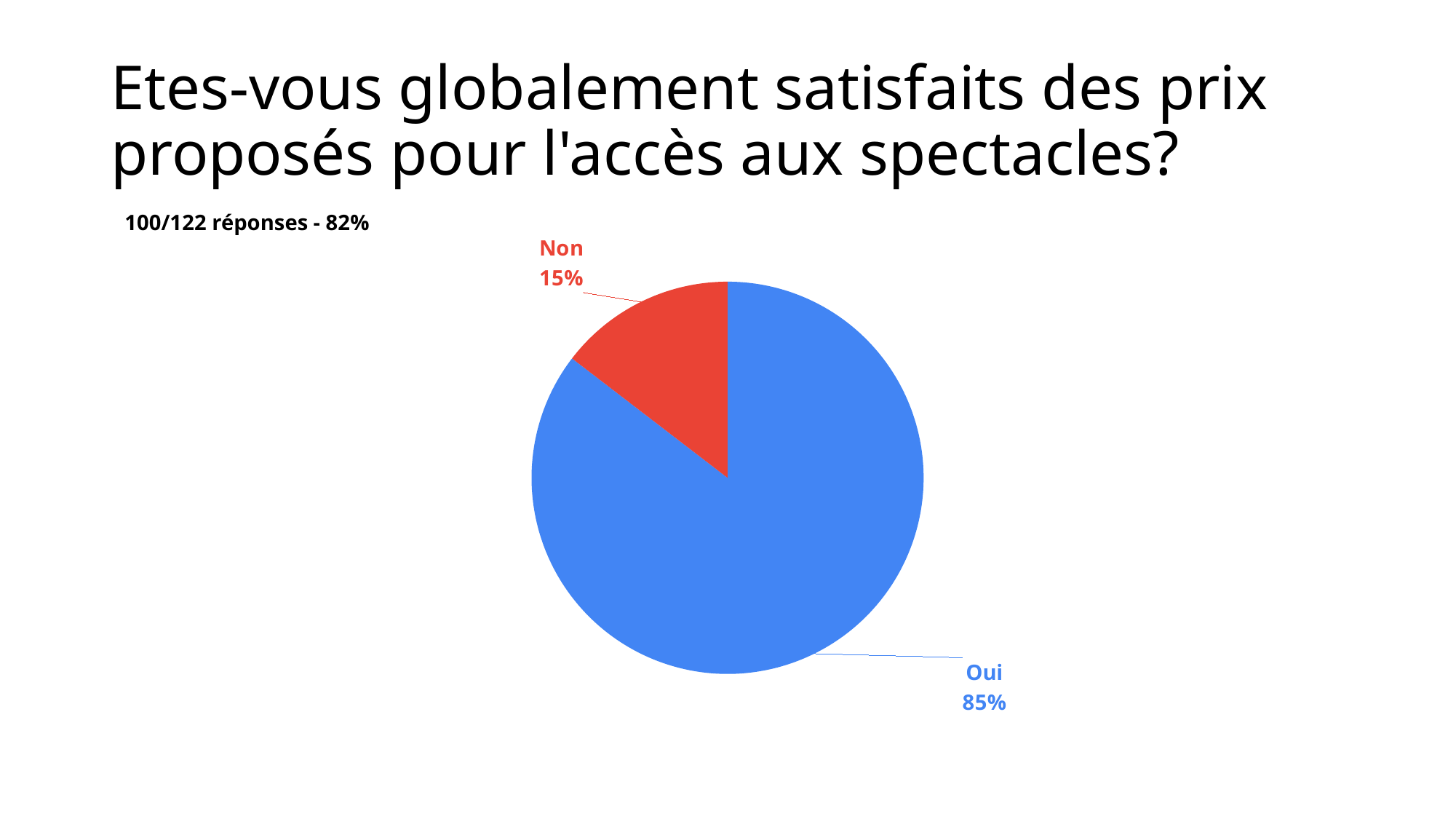
Which response has the smallest share of the pie? Non What colour is the "Oui" slice? blue What share of the pie does the "Oui" slice represent? 85% How many slices does the pie chart have? 2 What is the difference in percentage points between the "Oui" and "Non" shares? 70 What percentage of respondents answered "Oui"? 85% What colour is the "Non" slice? red Which response has the largest share of the pie? Oui Which is larger, the share for "Oui" or the share for "Non"? Oui What type of chart is shown on the slide? pie chart What percentage of respondents answered "Non"? 15%